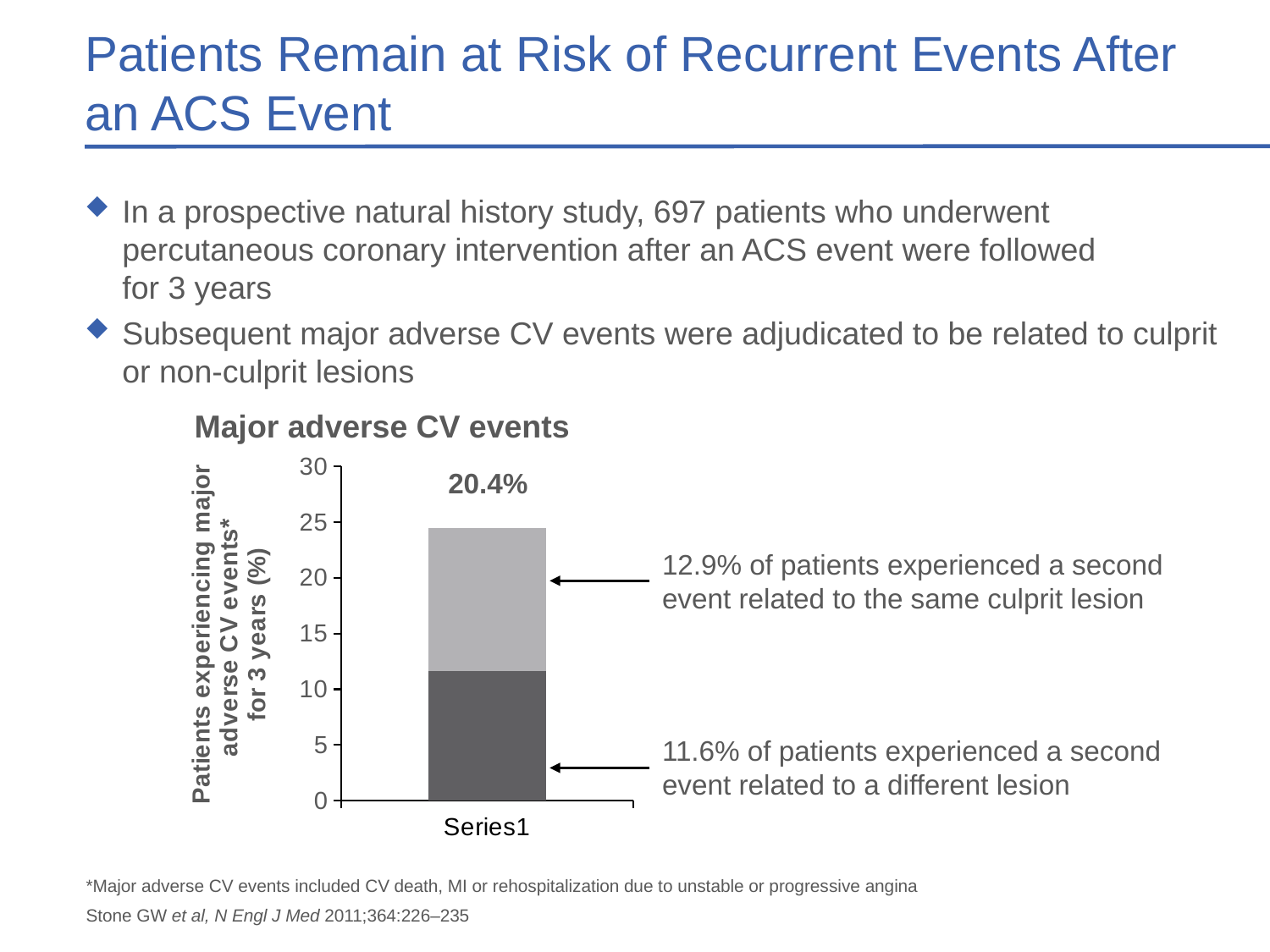
Is the top of the dark grey (different lesion) segment greater or less than 15 on the y axis? less What percentage of patients experienced a second event related to a different lesion? 11.6% How many bars are plotted in the chart? 1 What value is printed above the stacked bar? 20.4% What kind of chart is shown on the slide? Stacked bar chart Which was larger: the share of patients with a second event related to the same culprit lesion or to a different lesion? Same culprit lesion What percentage of patients experienced a second event related to the same culprit lesion? 12.9% Is the top of the dark grey (different lesion) segment greater or less than 10 on the y axis? greater What is the difference between the percentage of second events related to the same culprit lesion and those related to a different lesion? 1.3% Is the top of the stacked bar greater or less than 20 on the y axis? greater What is the title of the chart? Major adverse CV events